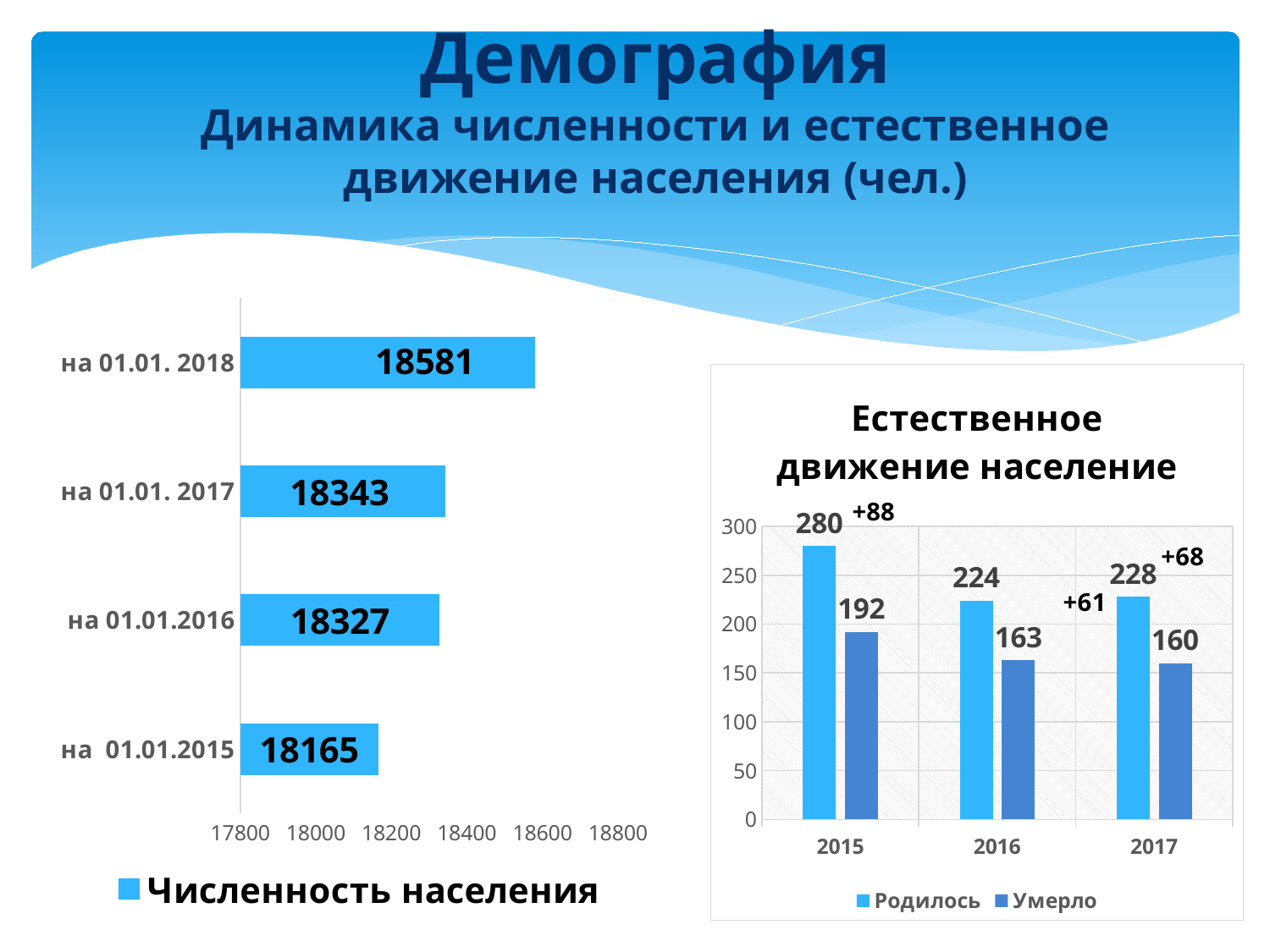
In the left chart (Численность населения), what is the population value for на 01.01. 2018? 18581 In the left chart (Численность населения), do the values rise or fall from 01.01.2015 to 01.01.2018? rise In the left chart (Численность населения), which date has the lowest population value? на 01.01.2015 In the chart titled Естественное движение население, what is the value of Родилось for 2015? 280 In the left chart (Численность населения), what is the difference between the values for на 01.01. 2018 and на 01.01. 2017? 238 In the chart titled Естественное движение население, what is the value of Умерло for 2017? 160 In the left chart (Численность населения), how many bars are plotted? 4 In the chart titled Естественное движение население, what is the difference between Родилось and Умерло in 2016? 61 In the chart titled Естественное движение население, which year has the highest Родилось value? 2015 In the left chart (Численность населения), what is the population value for на 01.01.2015? 18165 In the chart titled Естественное движение население, how many series does the legend list? 2 What kind of chart is the chart titled Естественное движение население? bar chart